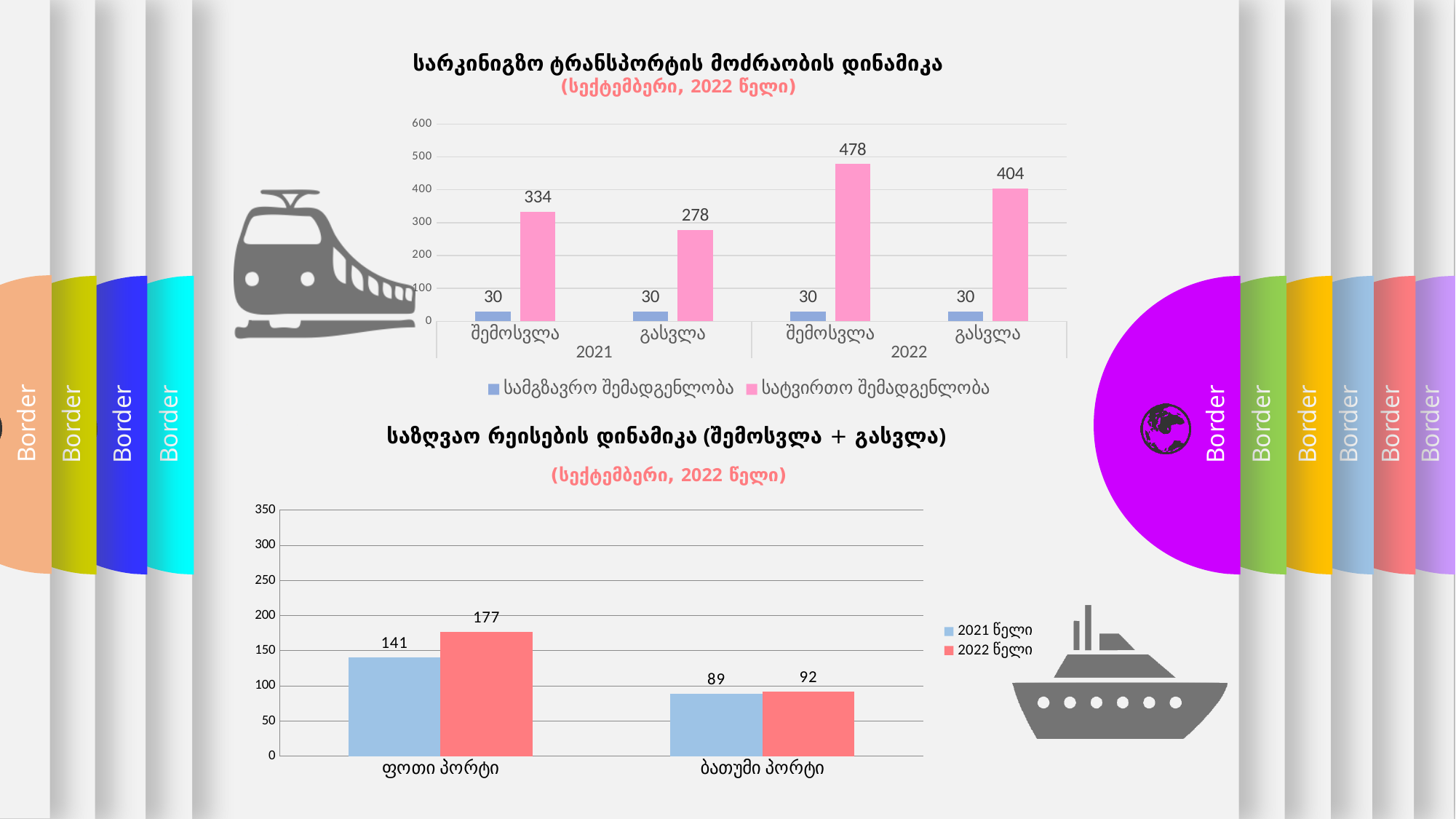
In the top chart (railway transport), what is the value of სამგზავრო შემადგენლობა for შემოსვლა in 2021? 30 In the bottom chart (sea voyages), what is the difference between the 2022 წელი and 2021 წელი values for ფოთი პორტი? 36 In the bottom chart (sea voyages), how many port categories are shown on the x axis? 2 In the top chart (railway transport), what is the difference between the სატვირთო შემადგენლობა values for გასვლა in 2022 and გასვლა in 2021? 126 What type of chart is the top chart (railway transport)? Bar chart In the top chart (railway transport), how many series does the legend list? 2 In the top chart (railway transport), which category has the highest სატვირთო შემადგენლობა value? შემოსვლა 2022 In the bottom chart (sea voyages), what is the value for ფოთი პორტი in 2022 წელი? 177 In the bottom chart (sea voyages), what is the value for ბათუმი პორტი in 2021 წელი? 89 In the bottom chart (sea voyages), which port has the larger 2021 წელი value, ფოთი პორტი or ბათუმი პორტი? ფოთი პორტი In the top chart (railway transport), what is the value of სატვირთო შემადგენლობა for გასვლა in 2021? 278 In the top chart (railway transport), what is the value of სატვირთო შემადგენლობა for შემოსვლა in 2022? 478